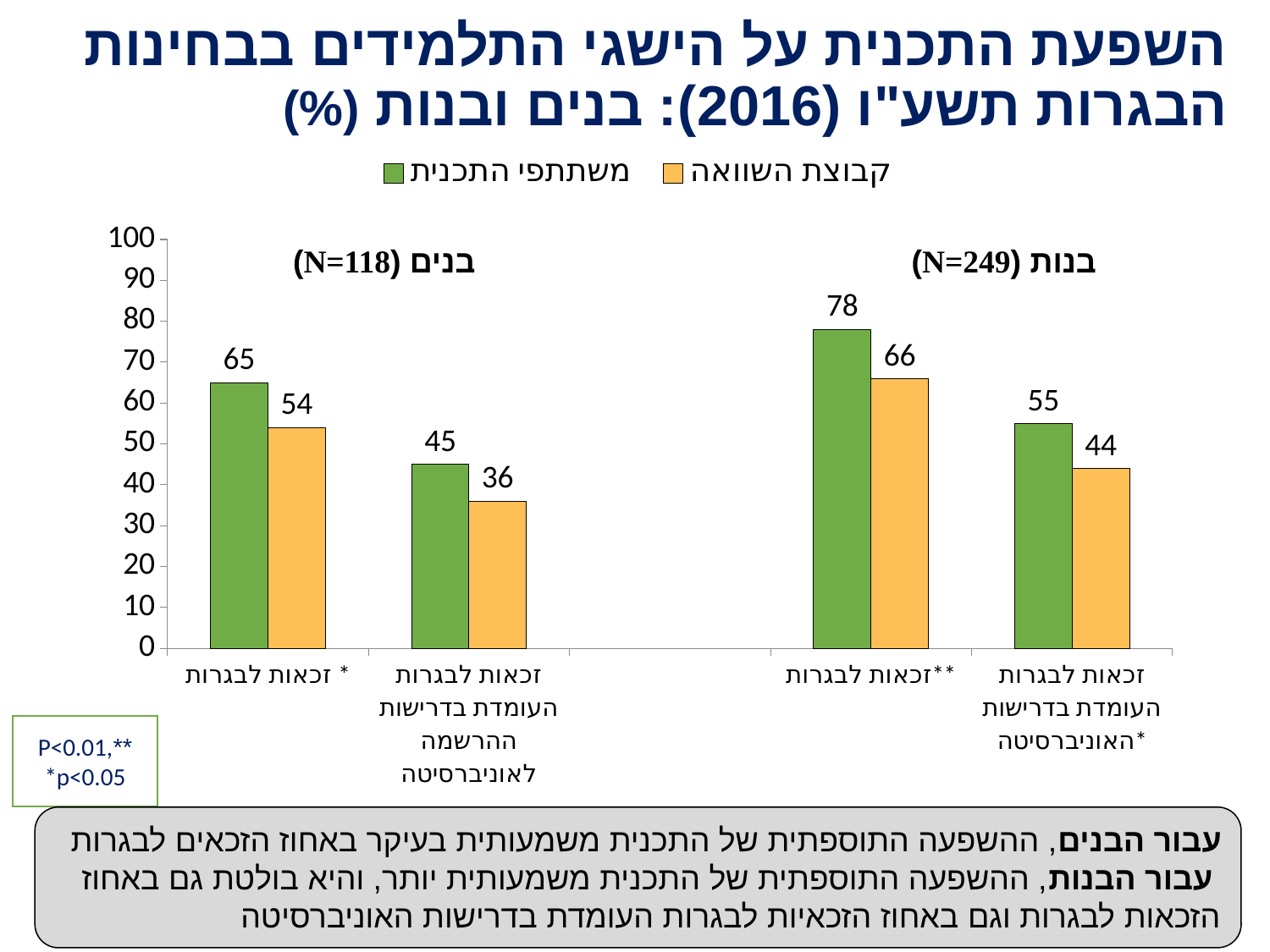
What is the value for קבוצת השוואה (comparison group) for זכאות לבגרות among boys (בנים, N=118)? 54 What kind of chart is shown on the slide? Bar chart How many series does the legend list? 2 What is the difference between משתתפי התכנית and קבוצת השוואה for זכאות לבגרות among girls (בנות)? 12 Which is larger: the value for משתתפי התכנית for זכאות לבגרות among boys (65) or the value for קבוצת השוואה for זכאות לבגרות among girls (66)? קבוצת השוואה among girls (66) Which bar has the highest value in the chart? משתתפי התכנית, זכאות לבגרות, בנות (78) Which bar has the lowest value in the chart? קבוצת השוואה, זכאות לבגרות העומדת בדרישות ההרשמה לאוניברסיטה, בנים (36) What is the difference between משתתפי התכנית and קבוצת השוואה for זכאות לבגרות העומדת בדרישות ההרשמה לאוניברסיטה among boys (בנים)? 9 What is the value for קבוצת השוואה (comparison group) for זכאות לבגרות העומדת בדרישות האוניברסיטה among girls (בנות, N=249)? 44 What is the value for משתתפי התכנית (program participants) for זכאות לבגרות among girls (בנות, N=249)? 78 What colour represents משתתפי התכנית (program participants) in the chart? Green What is the value for משתתפי התכנית (program participants) for זכאות לבגרות among boys (בנים, N=118)? 65